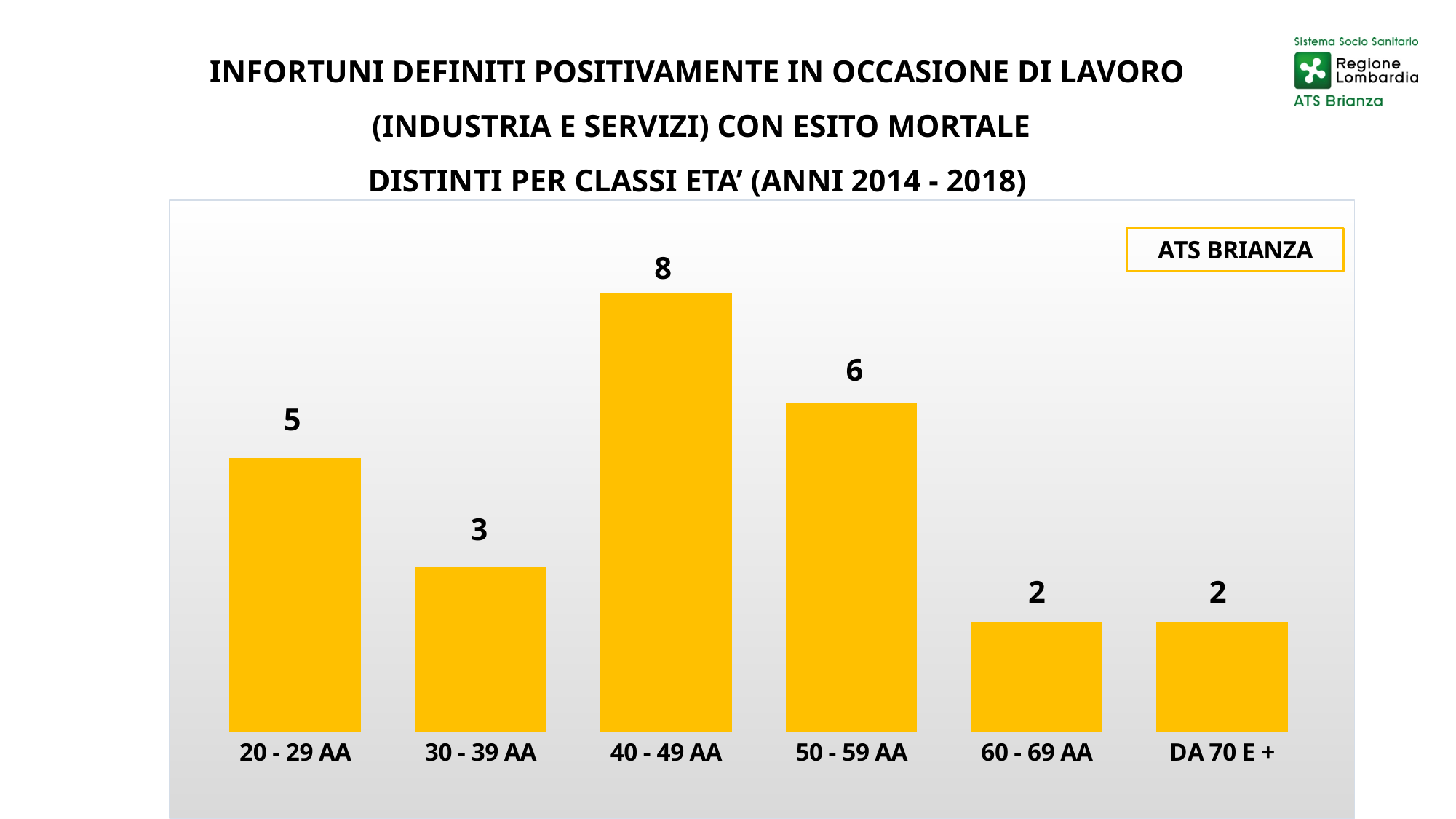
What is the difference between the values for 40 - 49 AA and 50 - 59 AA? 2 What kind of chart is shown on the slide? Bar chart How many age classes are shown in the chart? 6 What is the value for the 30 - 39 AA age class? 3 What is the difference between the values for 20 - 29 AA and 30 - 39 AA? 2 Which age class has the highest value? 40 - 49 AA What label appears in the box at the top right of the chart area? ATS BRIANZA What is the value for the 20 - 29 AA age class? 5 What is the value for the 40 - 49 AA age class? 8 What is the value for the 50 - 59 AA age class? 6 What is the value for the DA 70 E + age class? 2 Which is larger, the value for 20 - 29 AA or the value for 30 - 39 AA? 20 - 29 AA